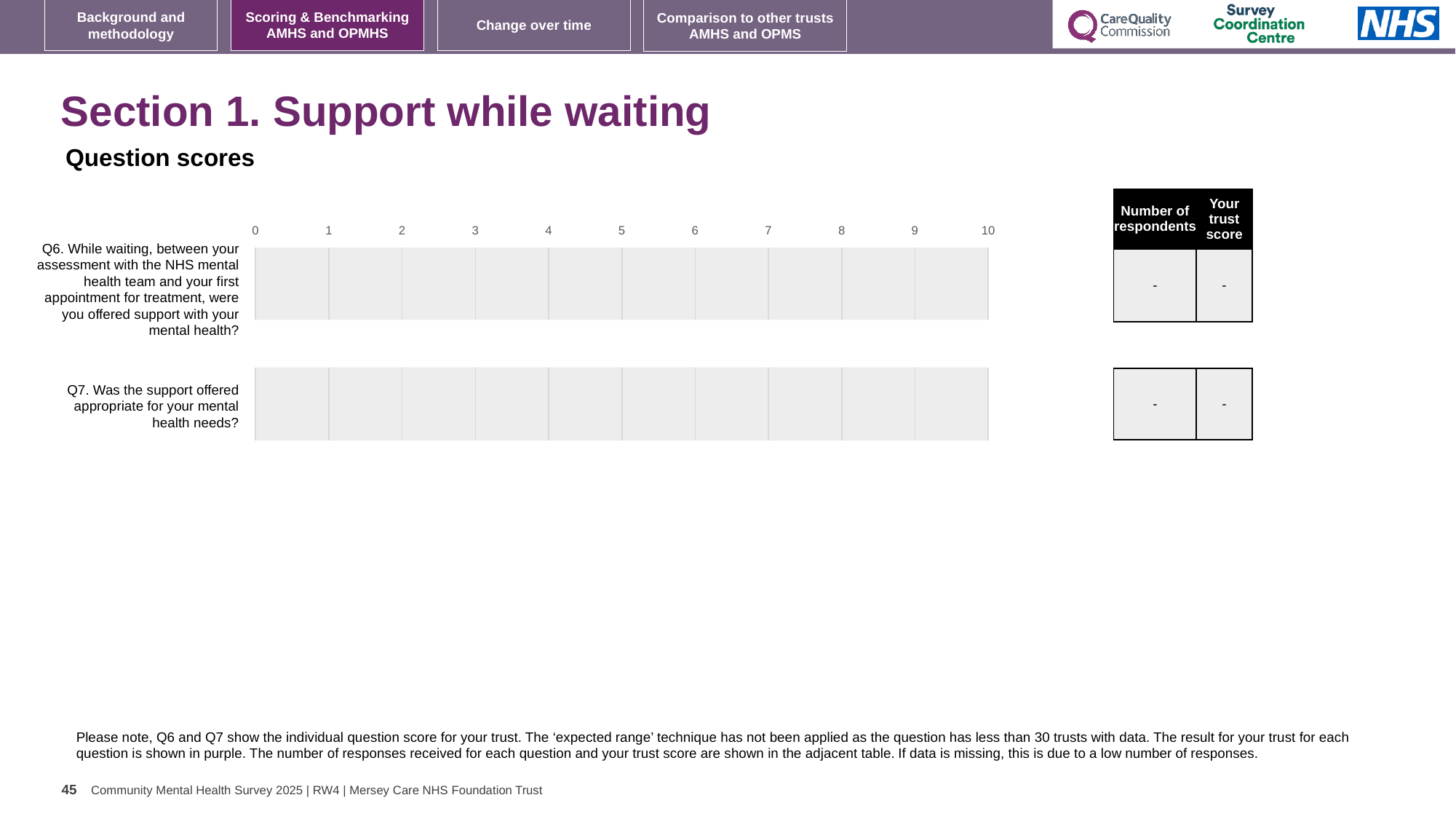
How many questions (categories) are listed on the chart's vertical axis? 2 What value is shown in the 'Your trust score' column for Q6? - What is the lowest value shown on the chart's horizontal axis? 0 Are any bars plotted for Q6 or Q7 on the chart? No What value is shown in the 'Number of respondents' column for Q7? - What is the highest value shown on the chart's horizontal axis? 10